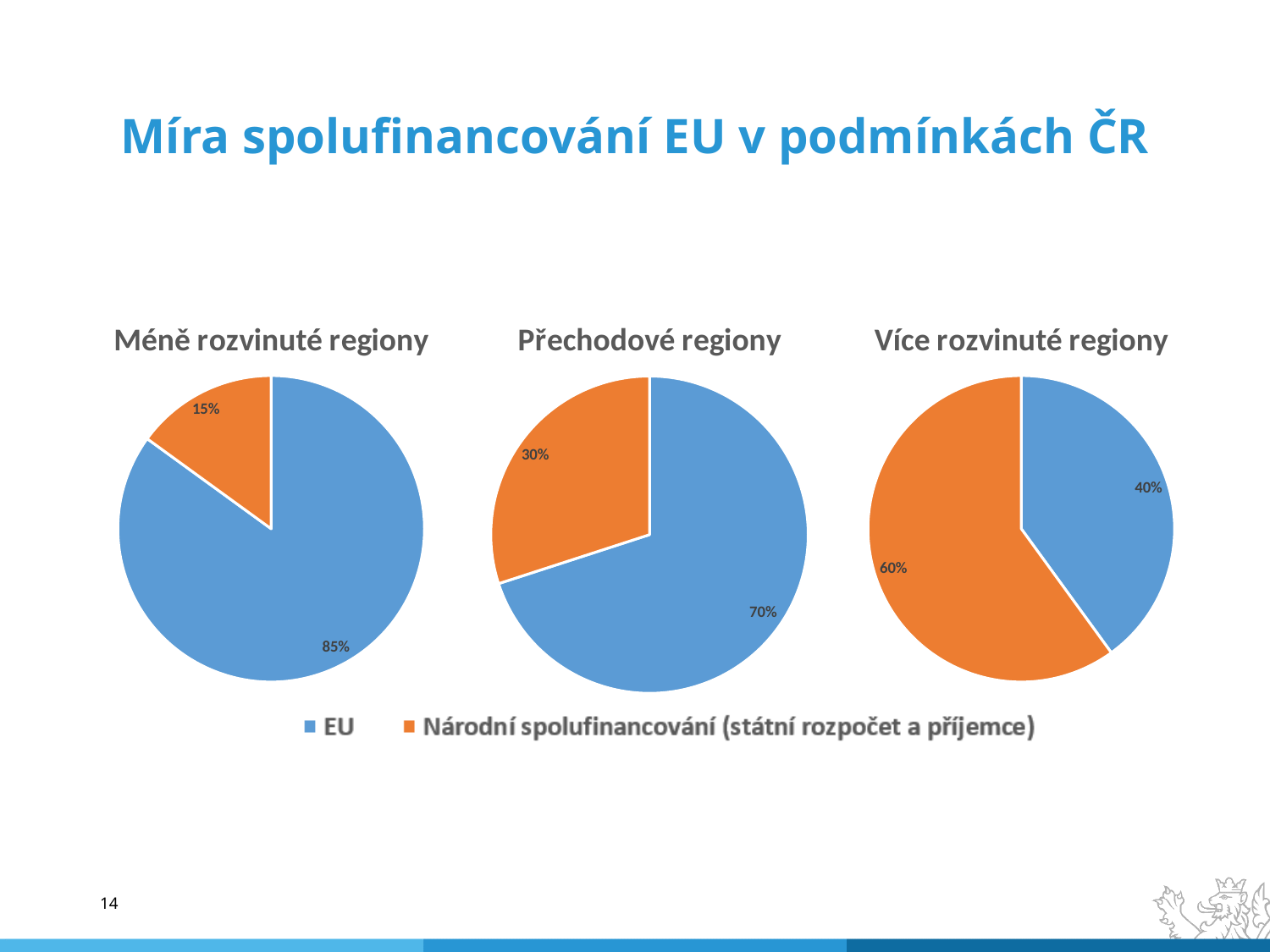
In the 'Více rozvinuté regiony' pie chart, which slice is larger: EU or Národní spolufinancování? Národní spolufinancování In the 'Přechodové regiony' pie chart, what share does EU have? 70% In the 'Méně rozvinuté regiony' pie chart, what share does Národní spolufinancování (státní rozpočet a příjemce) have? 15% In the 'Více rozvinuté regiony' pie chart, what share does EU have? 40% In the 'Přechodové regiony' pie chart, what share does Národní spolufinancování (státní rozpočet a příjemce) have? 30% What kind of chart is used for 'Přechodové regiony'? Pie chart In the 'Více rozvinuté regiony' pie chart, what share does Národní spolufinancování (státní rozpočet a příjemce) have? 60% How many series does the shared legend list? 2 In the 'Méně rozvinuté regiony' pie chart, what share does EU have? 85% In the 'Méně rozvinuté regiony' pie chart, what is the difference between the EU share and the Národní spolufinancování share? 70% Which colour represents EU in the pie charts? Blue In the 'Přechodové regiony' pie chart, which slice is the largest? EU